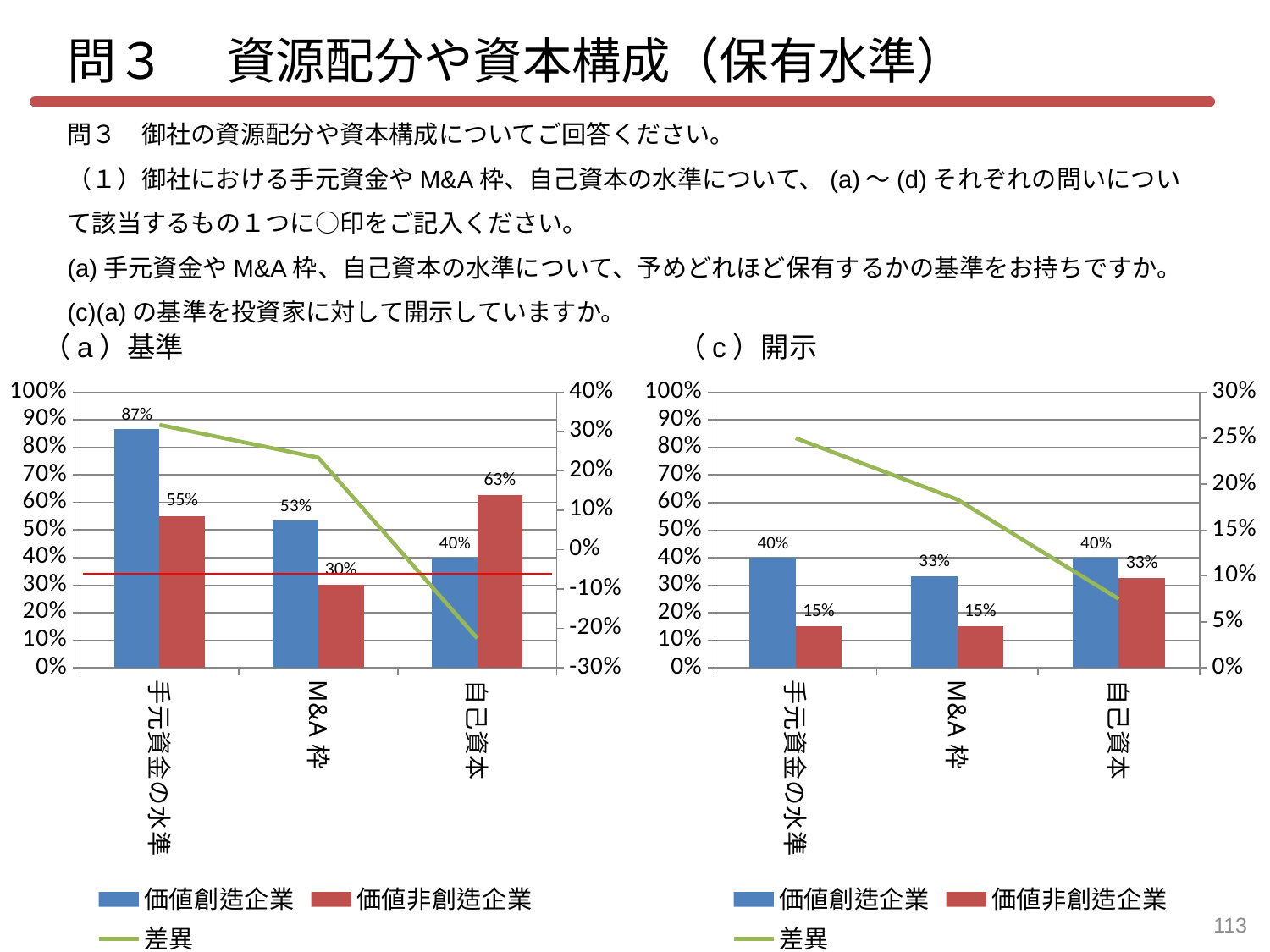
In the right chart (c) 開示, does the 差異 line rise or fall from 手元資金の水準 to 自己資本? fall In the left chart (a) 基準, which is larger for 自己資本: 価値創造企業 or 価値非創造企業? 価値非創造企業 In the right chart (c) 開示, what is the value for 価値創造企業 for 自己資本? 40% In the left chart (a) 基準, what is the value for 価値創造企業 for 手元資金の水準? 87% In the left chart (a) 基準, what is the difference between 価値創造企業 and 価値非創造企業 for 手元資金の水準? 32% In the left chart (a) 基準, which category has the highest value for 価値創造企業? 手元資金の水準 In the left chart (a) 基準, what is the value for 価値非創造企業 for 自己資本? 63% In the left chart (a) 基準, which category has the lowest value for 価値非創造企業? M&A枠 In the right chart (c) 開示, is the 差異 line value for 手元資金の水準 greater or less than 20%? greater In the right chart (c) 開示, what is the value for 価値非創造企業 for M&A枠? 15% How many series does the legend of the right chart (c) 開示 list? 3 In the right chart (c) 開示, what is the difference between 価値創造企業 and 価値非創造企業 for 自己資本? 7%